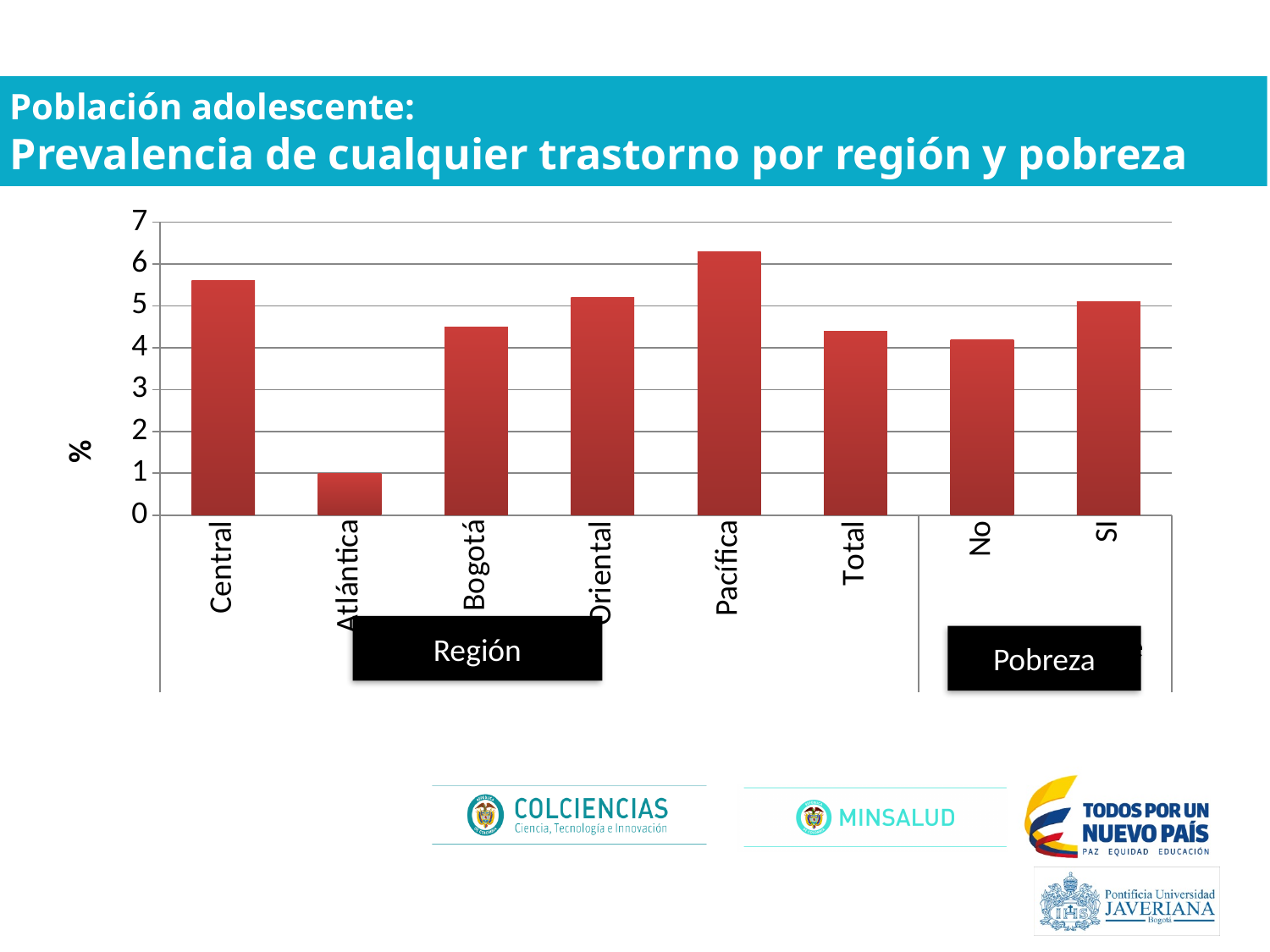
Is the value for Pacífica greater or less than 6? greater Is the value for Central greater or less than 5? greater Which is larger, the value for Central or the value for Bogotá? Central What kind of chart is shown on the slide? bar chart What label is shown on the vertical axis? % Which is larger, the value for SI or the value for No? SI Which category has the highest bar? Pacífica Is the value for Total greater or less than 5? less What are the two group labels shown below the category axis? Región and Pobreza Which category has the lowest bar? Atlántica How many bars are plotted in the chart? 8